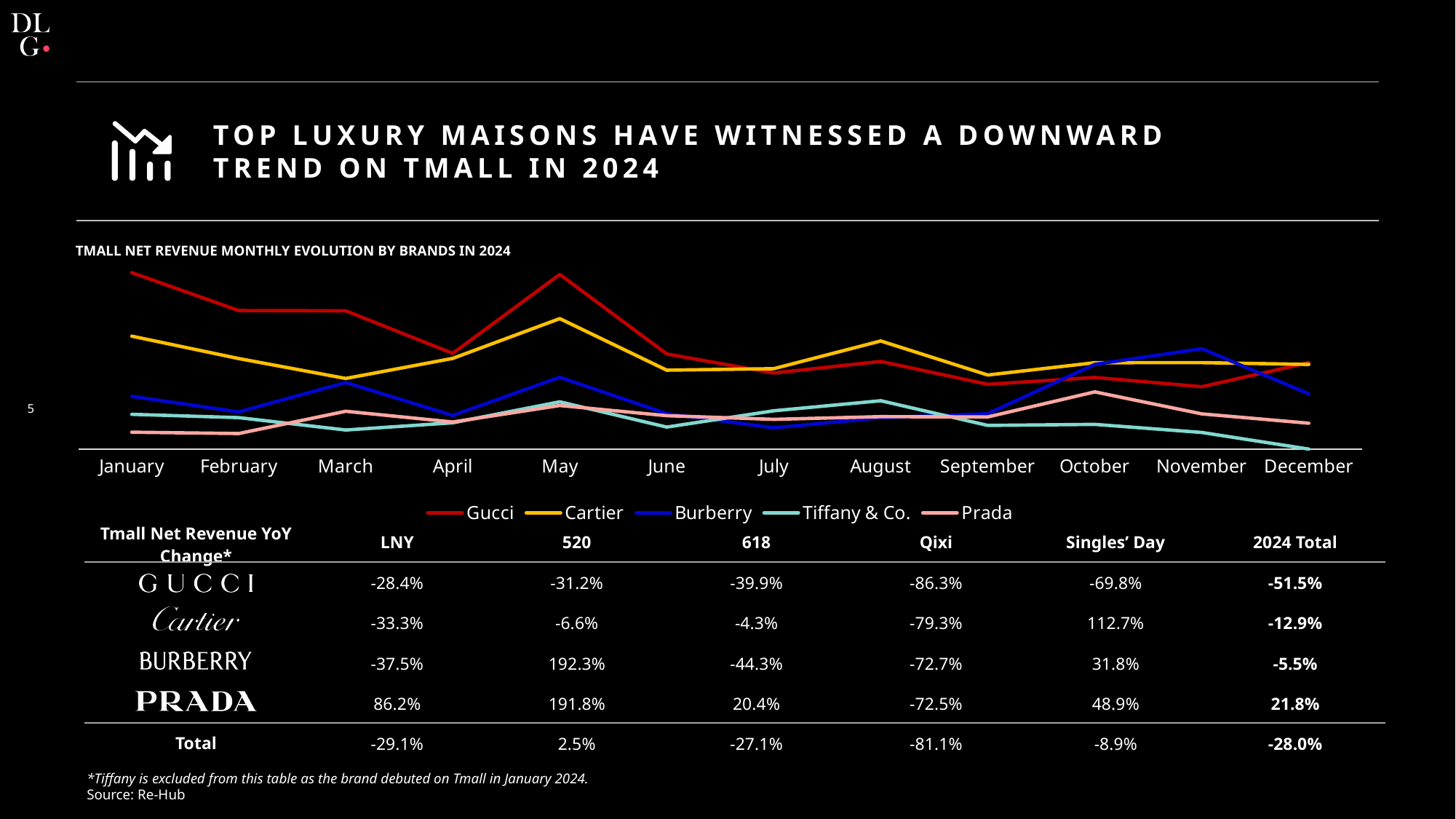
In which month does the Gucci line reach its highest point? January What kind of chart is shown on the slide? Line chart What is the title of the chart? TMALL NET REVENUE MONTHLY EVOLUTION BY BRANDS IN 2024 Which brand has the highest Tmall net revenue in November? Burberry In October, which is higher: Prada or Tiffany & Co.? Prada Which brand is plotted with the yellow line? Cartier Which brand has the lowest Tmall net revenue in December? Tiffany & Co. How many series does the chart's legend list? 5 How many months are plotted along the x axis of the chart? 12 Does the Gucci line overall rise or fall from January to December? Fall In January, which is higher: Gucci or Cartier? Gucci Which brand has the highest Tmall net revenue in January? Gucci